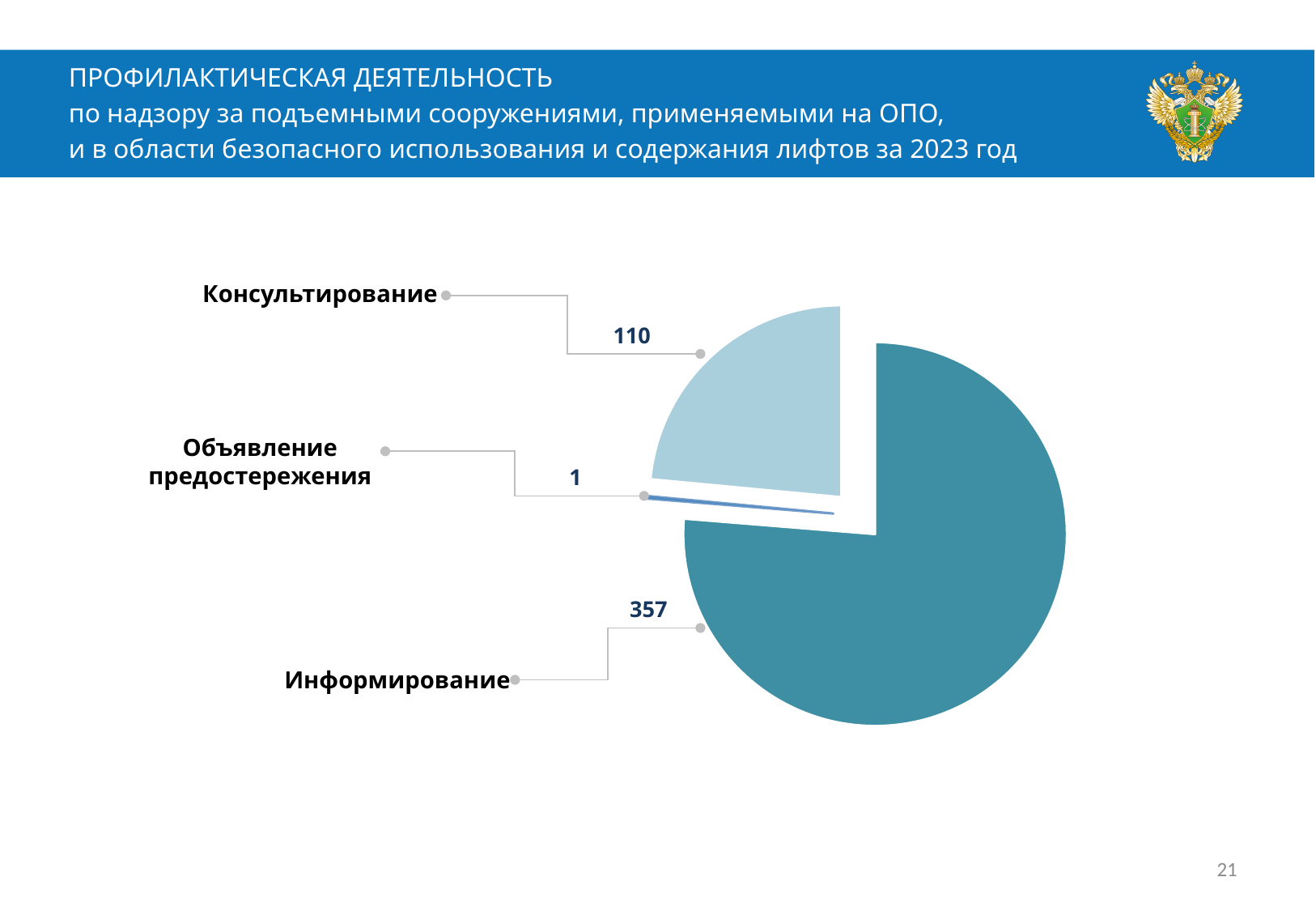
How many categories (slices) does the pie chart have? 3 Which category has the lowest value? Объявление предостережения Which is larger, the value for Консультирование or the value for Объявление предостережения? Консультирование What is the difference between the values for Информирование and Консультирование? 247 What type of chart is shown on the slide? pie chart What is the value for Объявление предостережения? 1 Which year does the slide title say the data covers? 2023 What is the value for Информирование? 357 What is the value for Консультирование? 110 What is the total of all three values in the pie chart? 468 To the nearest whole percent, what share of the total does Информирование represent? 76% Which category has the highest value? Информирование